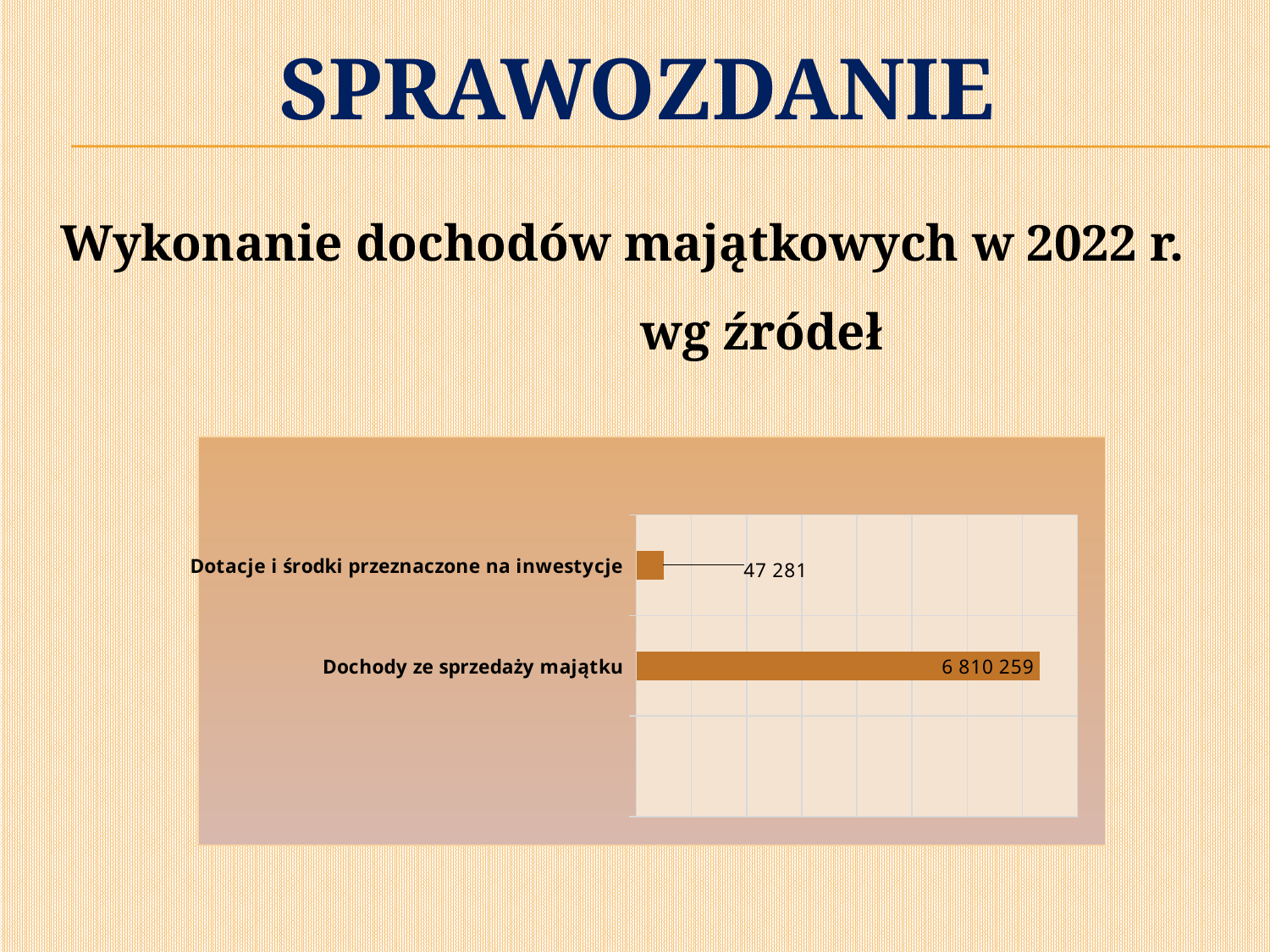
What is the value for "Dochody ze sprzedaży majątku"? 6 810 259 Are the bars in the chart horizontal or vertical? Horizontal What is the value for "Dotacje i środki przeznaczone na inwestycje"? 47 281 How many categories are shown in the chart? 2 What is the difference between the value for "Dochody ze sprzedaży majątku" and the value for "Dotacje i środki przeznaczone na inwestycje"? 6 762 978 What is the heading above the chart on the slide? Wykonanie dochodów majątkowych w 2022 r. wg źródeł Which category has the highest value? Dochody ze sprzedaży majątku What kind of chart is shown on the slide? Bar chart Which category has the lowest value? Dotacje i środki przeznaczone na inwestycje What is the sum of the two values shown in the chart? 6 857 540 Which is larger: the value for "Dotacje i środki przeznaczone na inwestycje" or the value for "Dochody ze sprzedaży majątku"? Dochody ze sprzedaży majątku